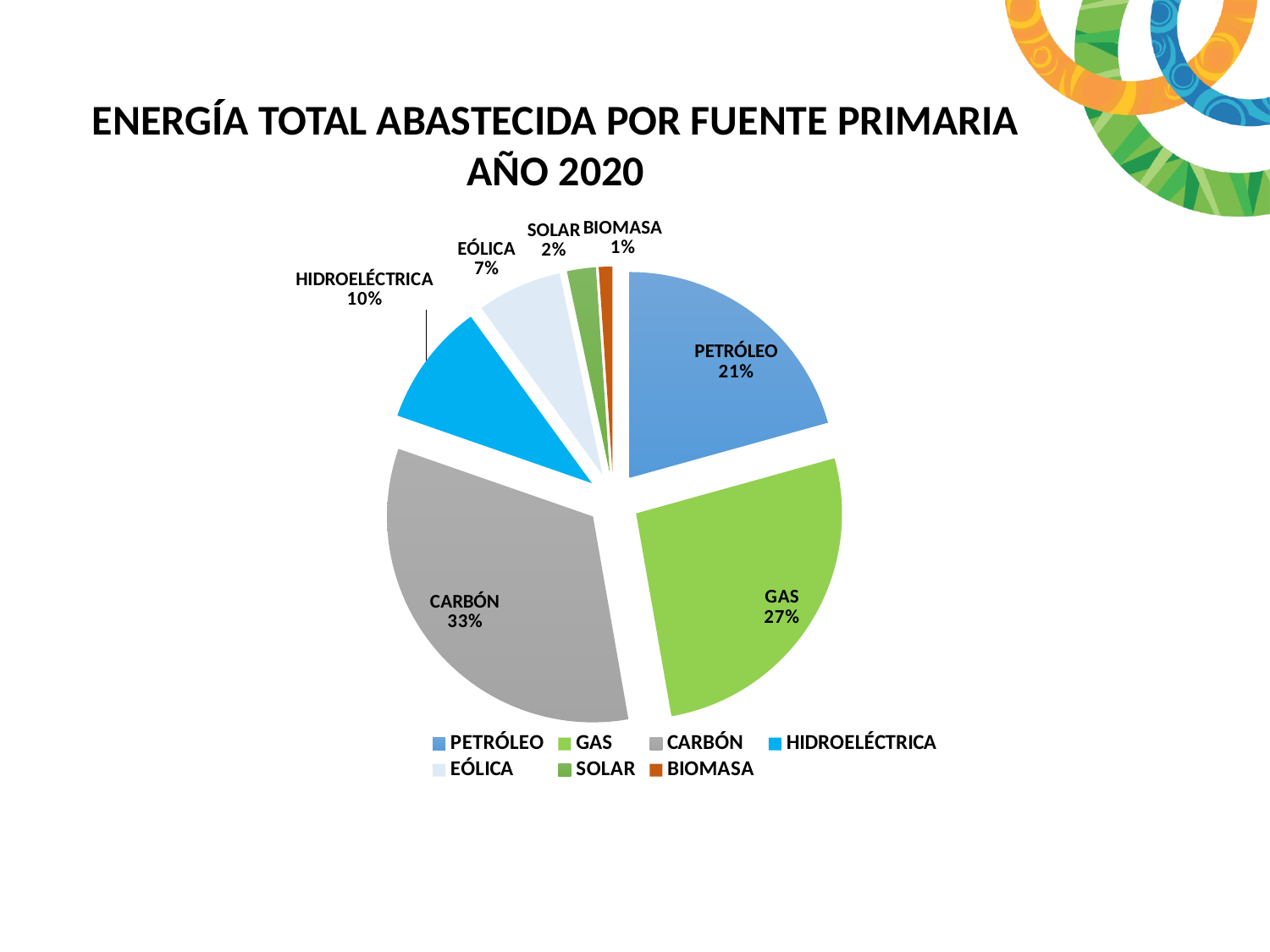
What is the value shown for PETRÓLEO? 21% What type of chart is shown on the slide? Pie chart Which is larger, the share for EÓLICA or the share for SOLAR? EÓLICA What is the value shown for GAS? 27% What is the title of the chart on the slide? ENERGÍA TOTAL ABASTECIDA POR FUENTE PRIMARIA AÑO 2020 What colour is the slice for HIDROELÉCTRICA? Blue Which energy source has the smallest share of the pie? BIOMASA What share of the pie does CARBÓN represent? 33% How many categories (slices) does the pie chart have? 7 What is the value shown for HIDROELÉCTRICA? 10% Which energy source has the largest share of the pie? CARBÓN What is the difference between the shares of CARBÓN and GAS? 6%